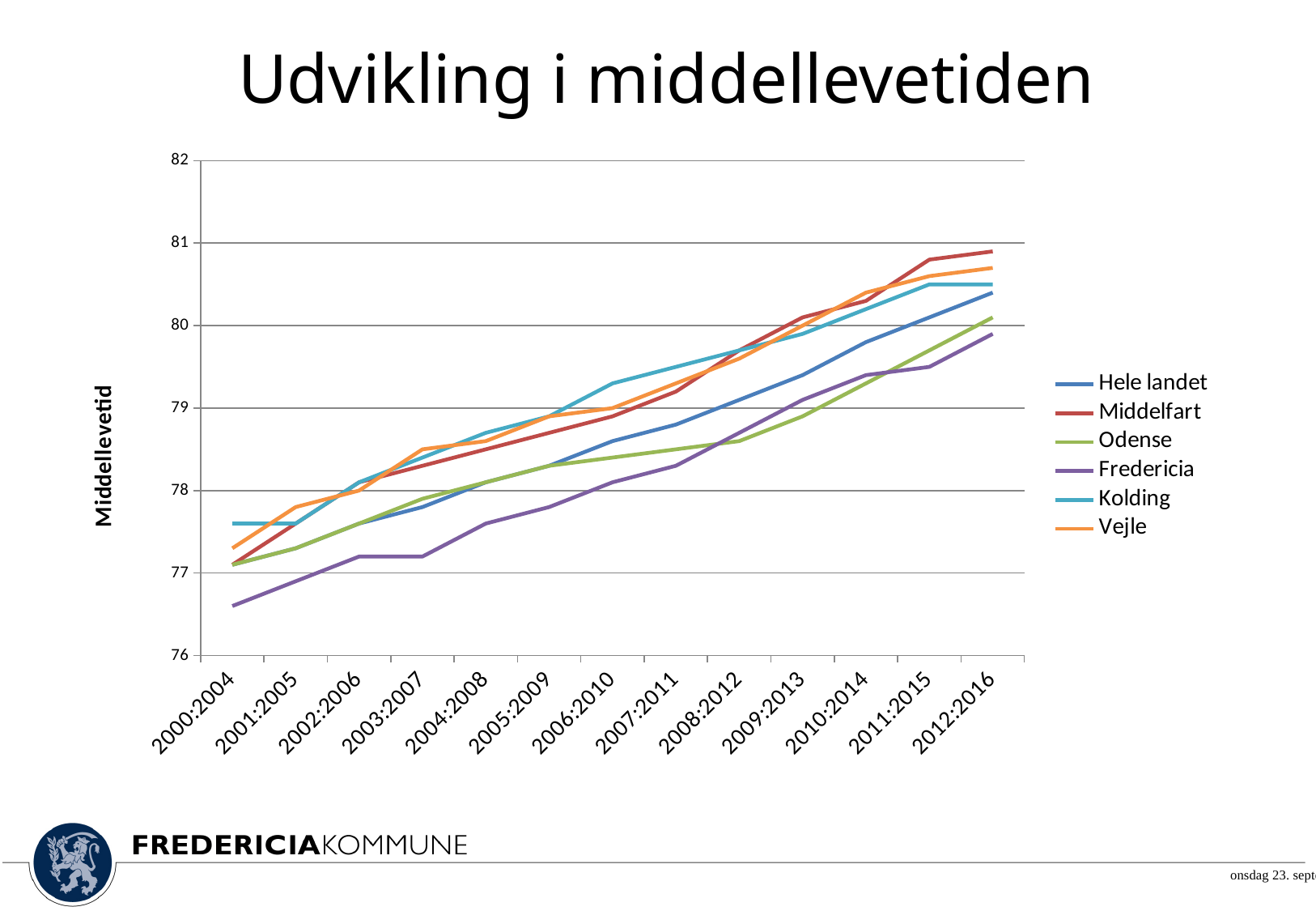
How many series does the legend list? 6 Is the value for Middelfart in 2012:2016 greater or less than 80? greater Do the values for Fredericia rise or fall from 2000:2004 to 2012:2016? rise Which is larger in 2012:2016, Middelfart or Odense? Middelfart What is the label on the vertical axis? Middellevetid Which series has the highest value in 2000:2004? Kolding Which is larger in 2000:2004, Kolding or Fredericia? Kolding How many periods are shown along the x axis? 13 Which series has the lowest value in 2000:2004? Fredericia Is the value for Fredericia in 2000:2004 greater or less than 77? less What type of chart is shown on the slide? line chart Is the value for Hele landet in 2012:2016 greater or less than 80? greater